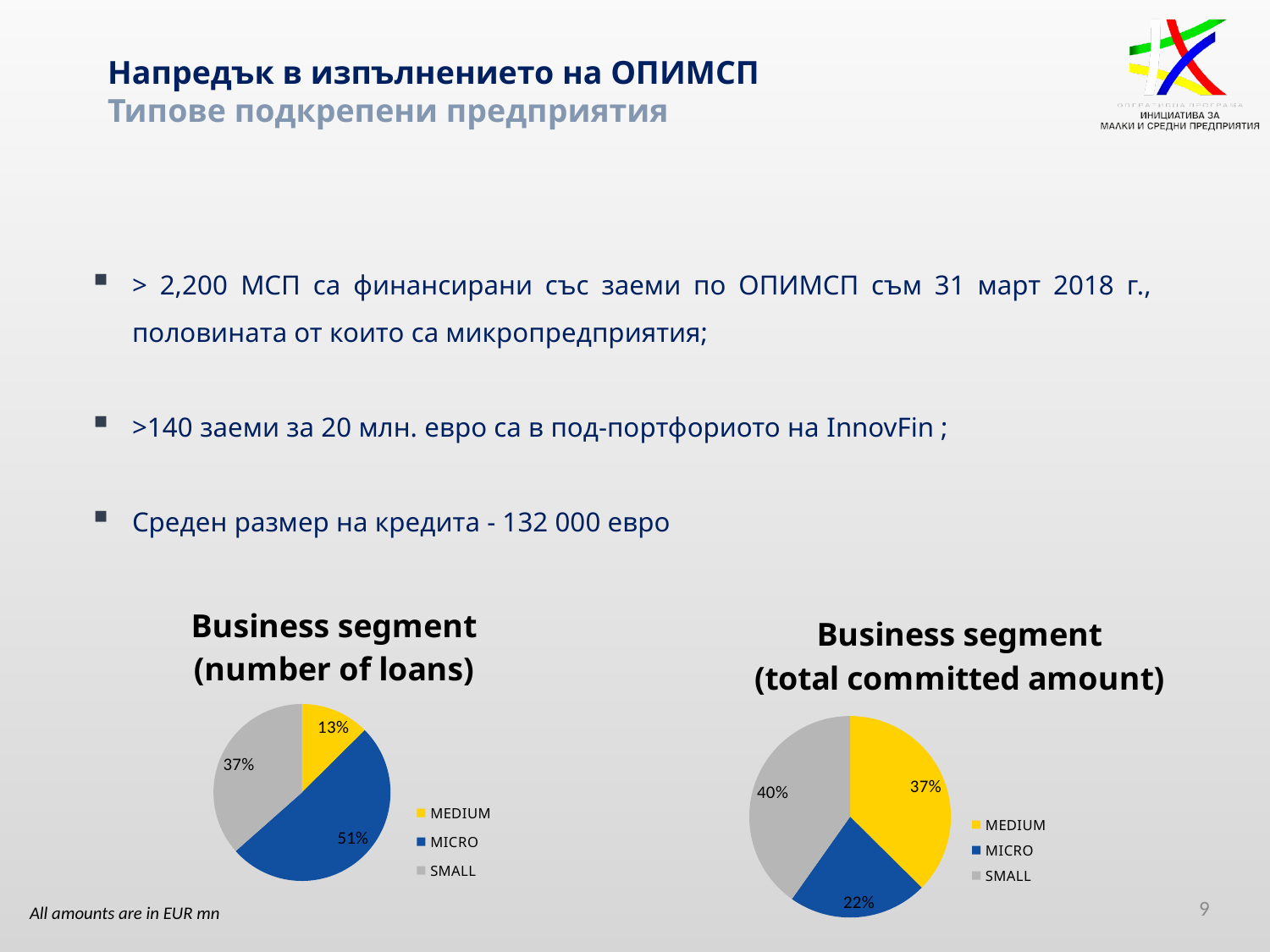
In the 'Business segment (number of loans)' chart, what share of loans is SMALL? 37% In the 'Business segment (number of loans)' chart, what is the difference in percentage points between the MICRO and MEDIUM shares? 38 percentage points In the 'Business segment (total committed amount)' chart, which is larger, the SMALL share or the MICRO share? SMALL In the 'Business segment (number of loans)' chart, which segment has the largest share? MICRO What type of chart is the 'Business segment (number of loans)' chart? Pie chart In the 'Business segment (total committed amount)' chart, what share is MICRO? 22% In the 'Business segment (number of loans)' chart, what share of loans is MEDIUM? 13% In the 'Business segment (total committed amount)' chart, what share is SMALL? 40% In the 'Business segment (total committed amount)' chart, which segment has the smallest share? MICRO How many segments does the legend of the 'Business segment (total committed amount)' chart list? 3 In the 'Business segment (number of loans)' chart, what share of loans is MICRO? 51% In the 'Business segment (total committed amount)' chart, what share is MEDIUM? 37%